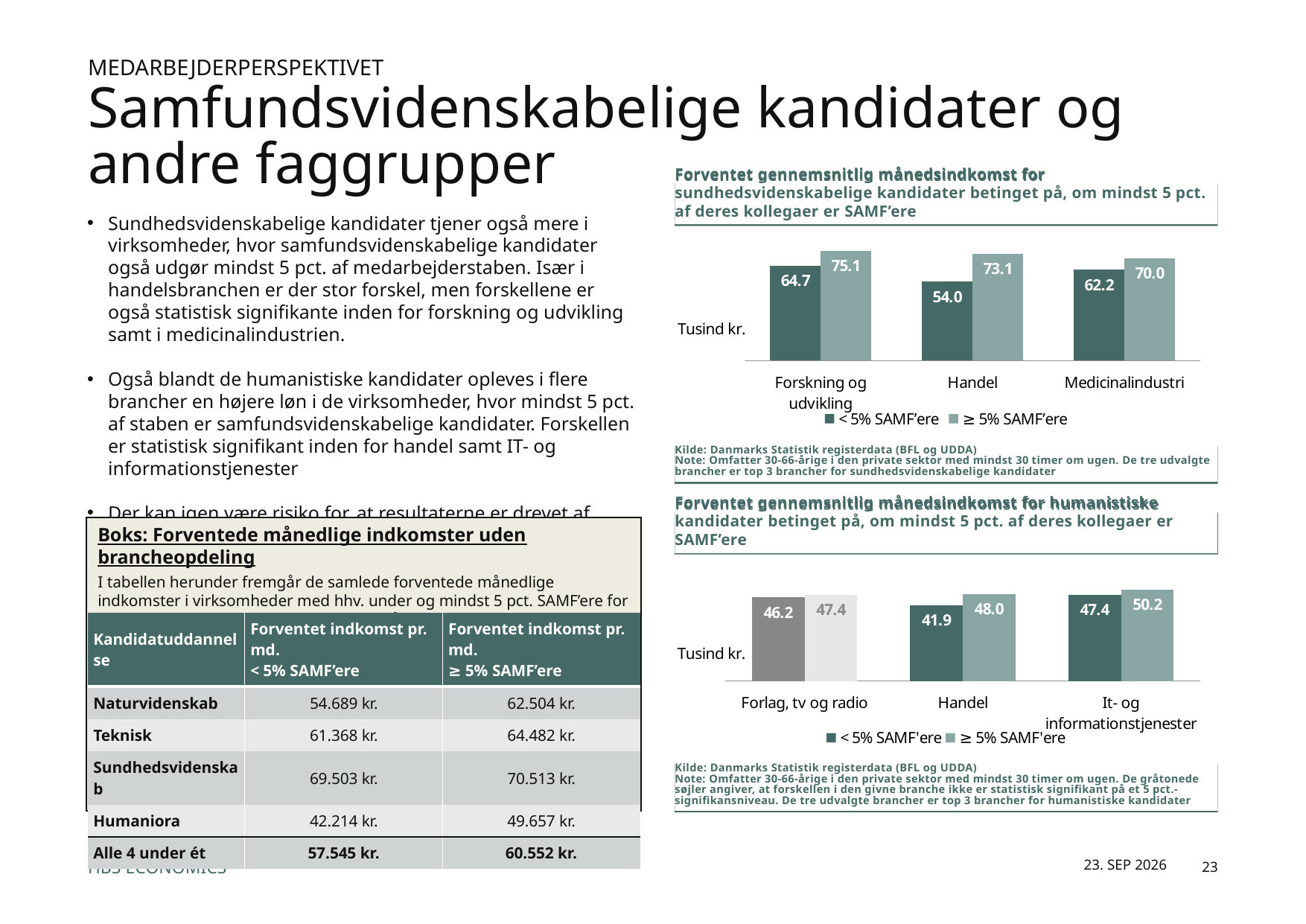
In the bottom chart (humanistiske kandidater), what is the value for Handel in the '< 5% SAMF'ere' series? 41.9 In the top chart (sundhedsvidenskabelige kandidater), which category has the lowest '< 5% SAMF'ere' value? Handel In the bottom chart (humanistiske kandidater), which category has the lowest '< 5% SAMF'ere' value? Handel In the top chart (sundhedsvidenskabelige kandidater), what is the value for Handel in the '< 5% SAMF'ere' series? 54.0 What type of chart is the top chart (sundhedsvidenskabelige kandidater)? Bar chart In the bottom chart (humanistiske kandidater), what is the difference between the '≥ 5% SAMF'ere' and '< 5% SAMF'ere' values for Handel? 6.1 In the bottom chart (humanistiske kandidater), what is the value for It- og informationstjenester in the '≥ 5% SAMF'ere' series? 50.2 In the top chart (sundhedsvidenskabelige kandidater), what is the difference between the '≥ 5% SAMF'ere' and '< 5% SAMF'ere' values for Handel? 19.1 How many series does the legend of the bottom chart (humanistiske kandidater) list? 2 In the top chart (sundhedsvidenskabelige kandidater), how many categories are shown on the x axis? 3 In the top chart (sundhedsvidenskabelige kandidater), what is the value for Forskning og udvikling in the '≥ 5% SAMF'ere' series? 75.1 In the top chart (sundhedsvidenskabelige kandidater), which category has the highest '≥ 5% SAMF'ere' value? Forskning og udvikling